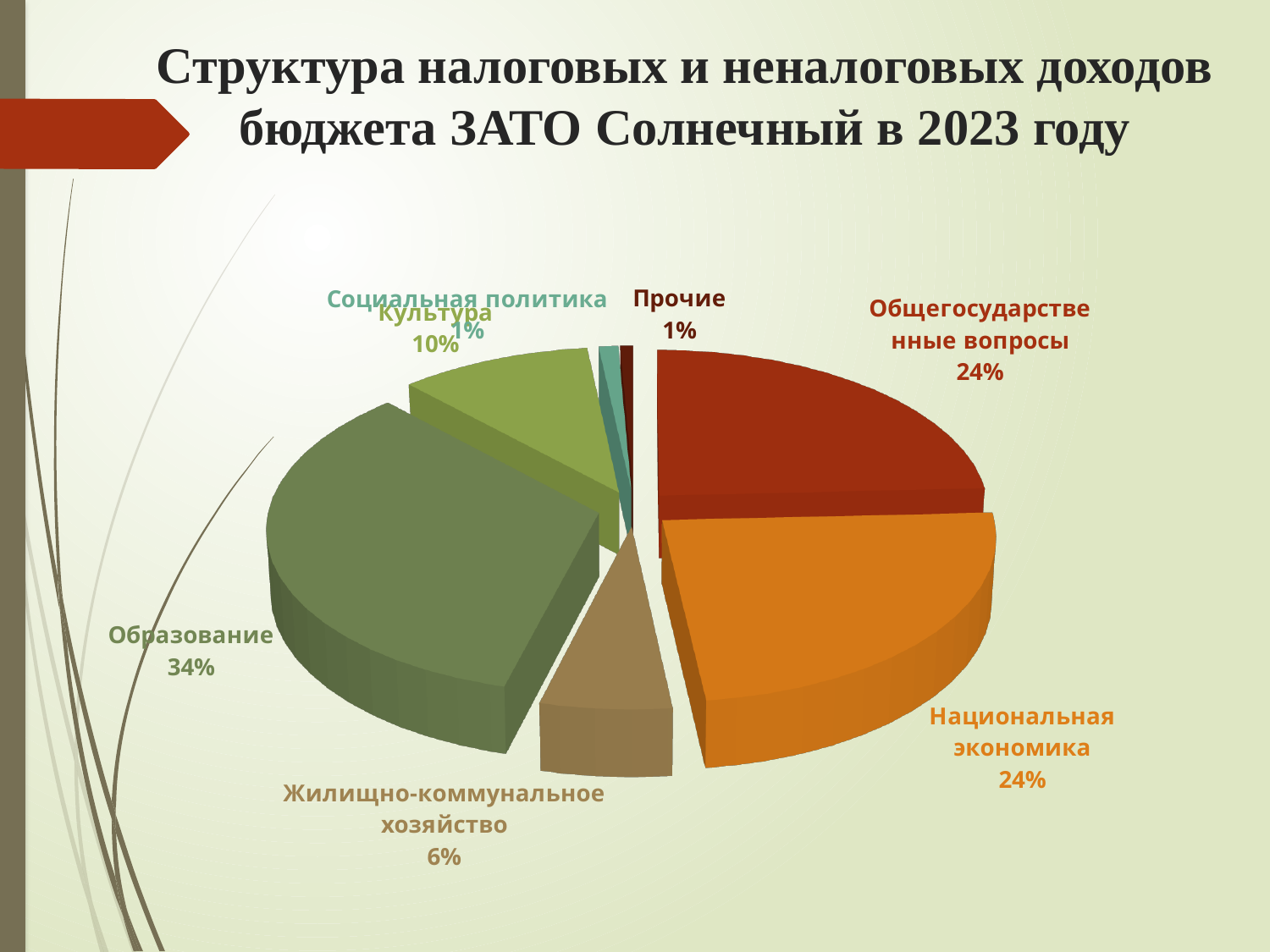
Which category has the largest slice of the pie? Образование What is the title of the chart on the slide? Структура налоговых и неналоговых доходов бюджета ЗАТО Солнечный в 2023 году What is the value shown for Общегосударственные вопросы? 24% Which is larger, Образование or Национальная экономика? Образование What kind of chart is shown on the slide? pie chart What is the value shown for Прочие? 1% What is the value shown for Национальная экономика? 24% What is the difference in percentage points between Образование and Культура? 24 What share of the pie does Образование have? 34% What is the value shown for Культура? 10% How many categories are shown in the pie chart? 7 What is the value shown for Жилищно-коммунальное хозяйство? 6%